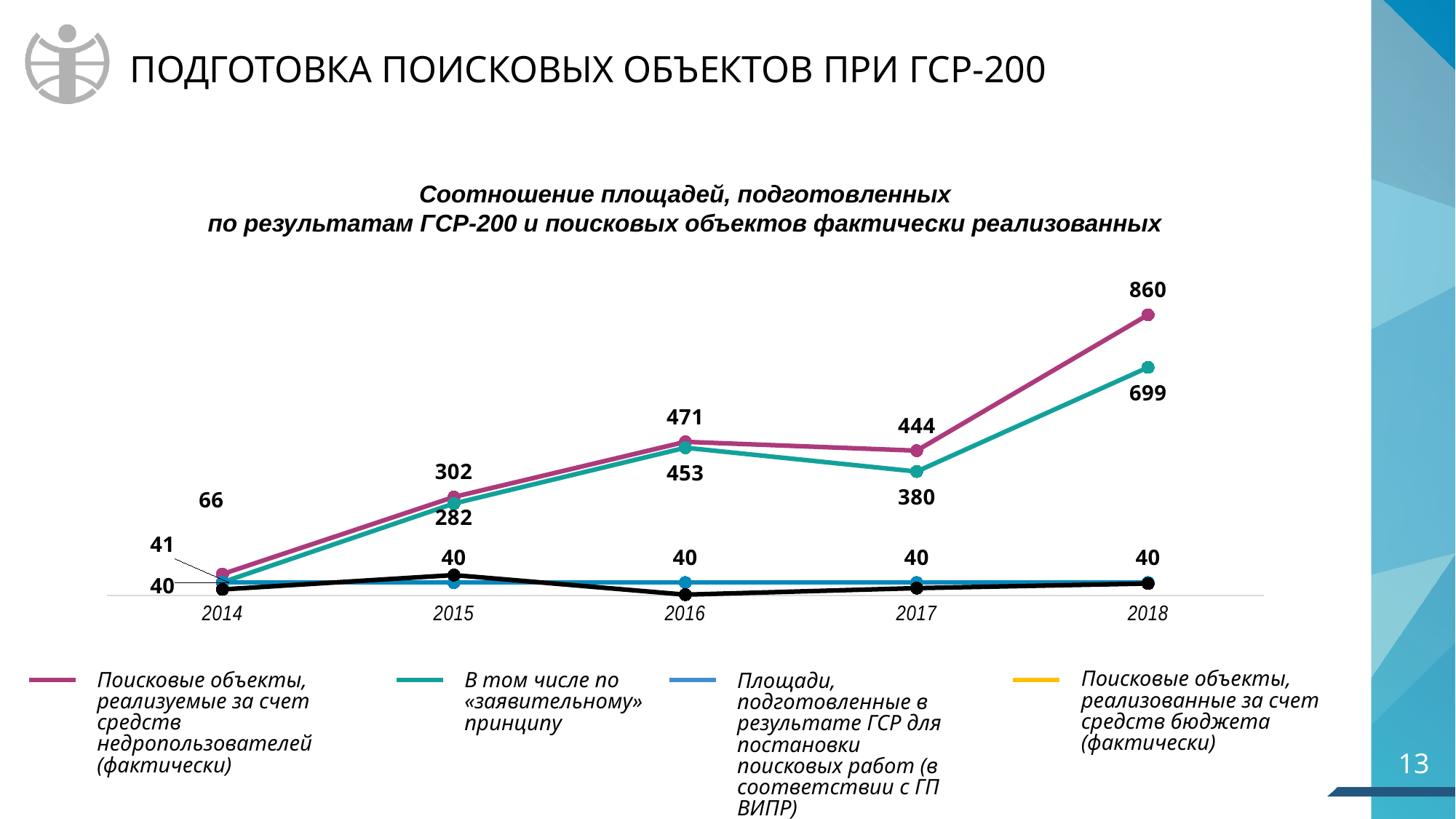
In which year is the series 'Поисковые объекты, реализуемые за счет средств недропользователей (фактически)' highest? 2018 How many series does the legend list? 4 Which is larger for the series 'Поисковые объекты, реализуемые за счет средств недропользователей (фактически)': the value for 2016 or the value for 2017? 2016 What type of chart is shown on the slide? line chart What is the value for 2015 for the series 'Площади, подготовленные в результате ГСР для постановки поисковых работ (в соответствии с ГП ВИПР)'? 40 What is the value for 2017 for the series 'В том числе по «заявительному» принципу'? 380 In which year is the series 'В том числе по «заявительному» принципу' lowest? 2014 What is the difference between the 2018 values of the series 'Поисковые объекты, реализуемые за счет средств недропользователей (фактически)' and 'В том числе по «заявительному» принципу'? 161 What colour is the line for the series 'В том числе по «заявительному» принципу'? teal What is the value for 2018 for the series 'Поисковые объекты, реализуемые за счет средств недропользователей (фактически)'? 860 What is the value for 2016 for the series 'Поисковые объекты, реализуемые за счет средств недропользователей (фактически)'? 471 How many years are shown on the x axis? 5